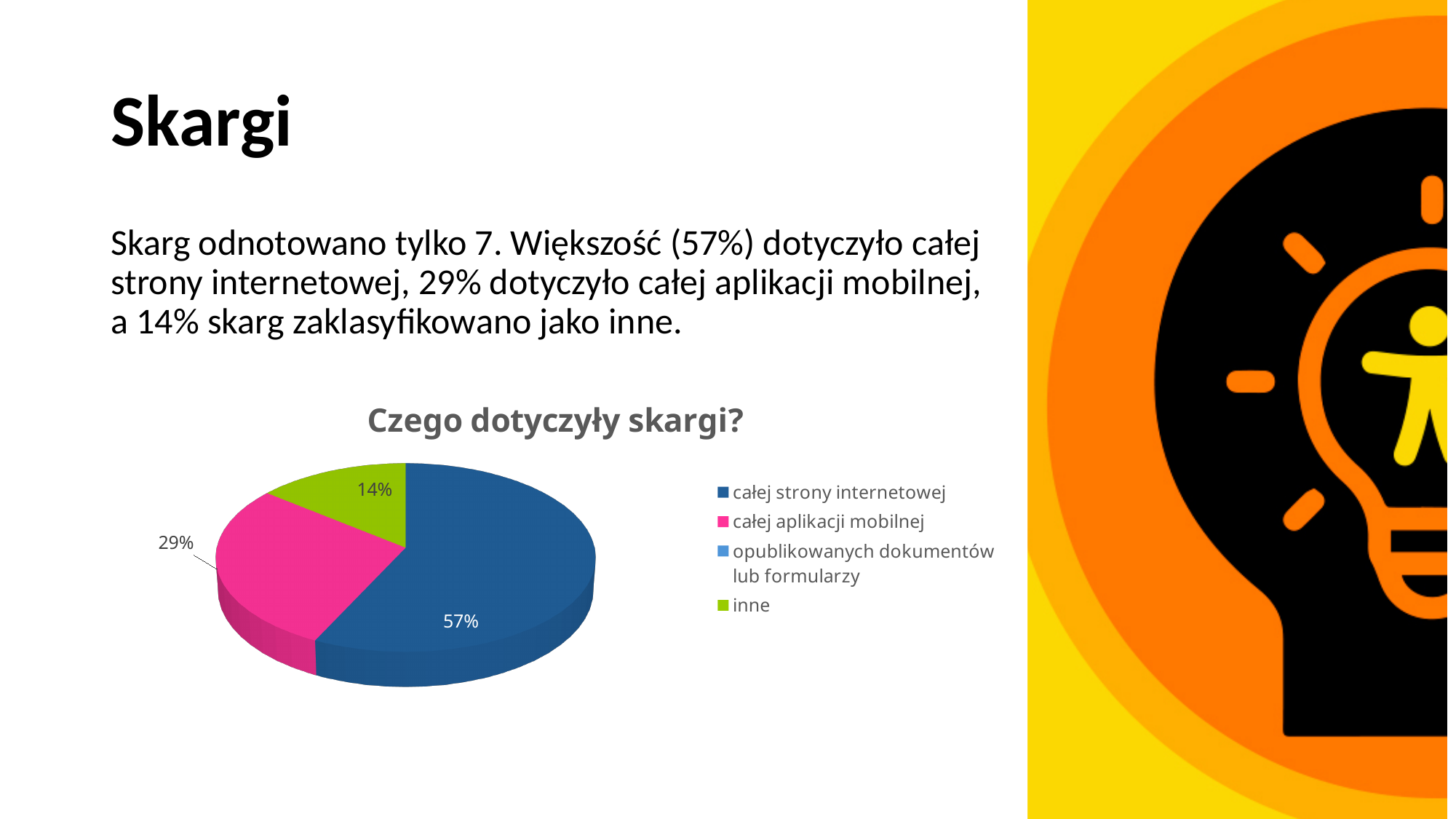
What share of the pie does 'całej strony internetowej' have? 57% What share of the pie does 'całej aplikacji mobilnej' have? 29% What is the title of the chart? Czego dotyczyły skargi? Which is larger: the share for 'całej aplikacji mobilnej' or the share for 'inne'? całej aplikacji mobilnej What kind of chart is shown on the slide? pie chart How many entries does the chart legend list? 4 Which category with a visible slice has the smallest share of the pie? inne What is the difference in percentage points between 'całej aplikacji mobilnej' and 'inne'? 15 What share of the pie does 'inne' have? 14% Which legend entry is shown in pink? całej aplikacji mobilnej Which category has the largest slice of the pie? całej strony internetowej What is the difference in percentage points between 'całej strony internetowej' and 'całej aplikacji mobilnej'? 28